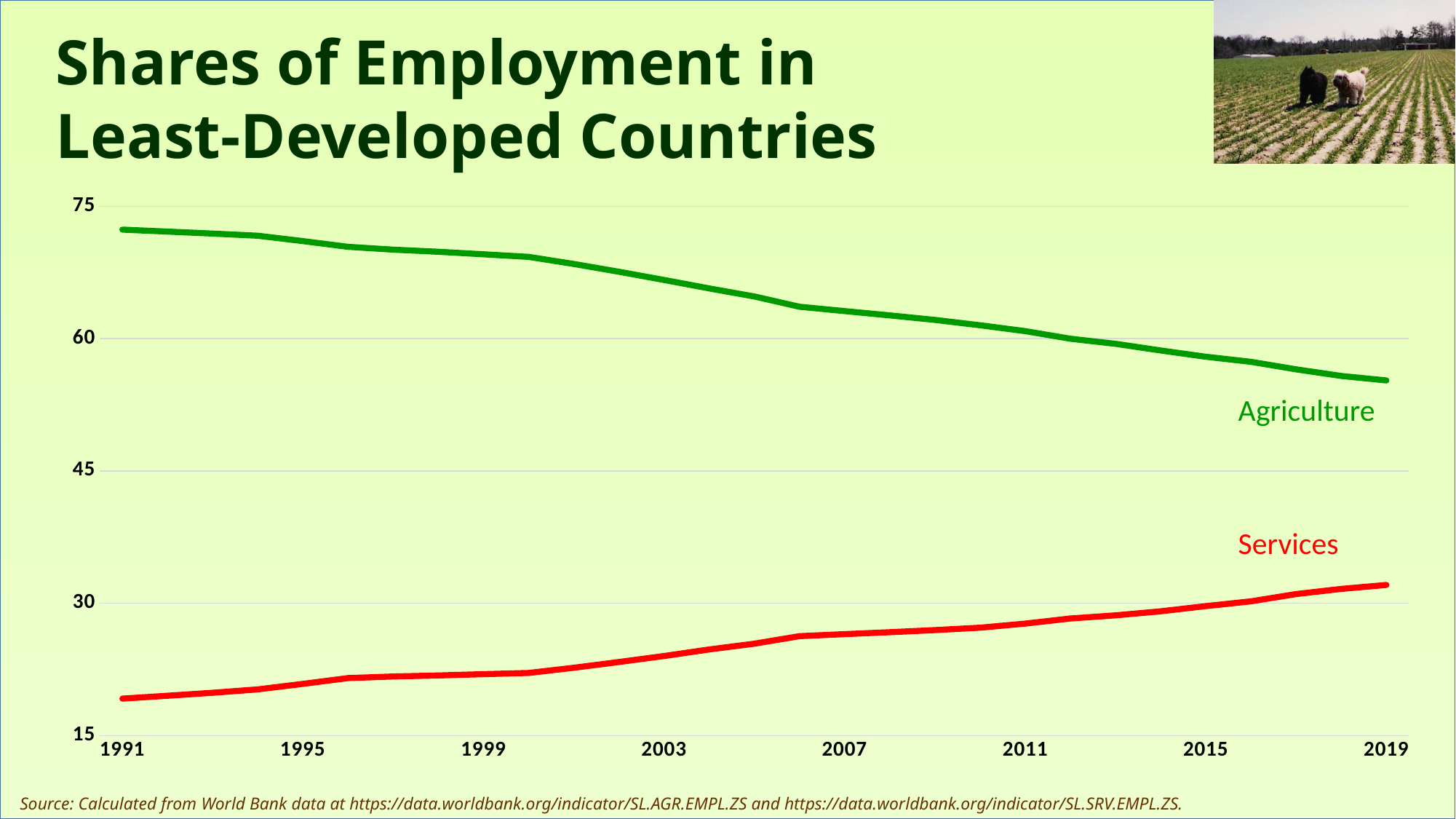
Is the value for Services in 2019 greater or less than 30? greater Is the value for Agriculture in 1991 greater or less than 60? greater What kind of chart is shown on the slide? line chart Which series has the higher value in 2019, Agriculture or Services? Agriculture How many series are plotted on the chart? 2 Does the Services line rise or fall from 1991 to 2019? rise Is the value for Agriculture in 2019 greater or less than 60? less What is the title of the chart? Shares of Employment in Least-Developed Countries Which series is labelled in green? Agriculture In which year shown on the x axis is the Services value highest? 2019 Does the Agriculture line rise or fall from 1991 to 2019? fall